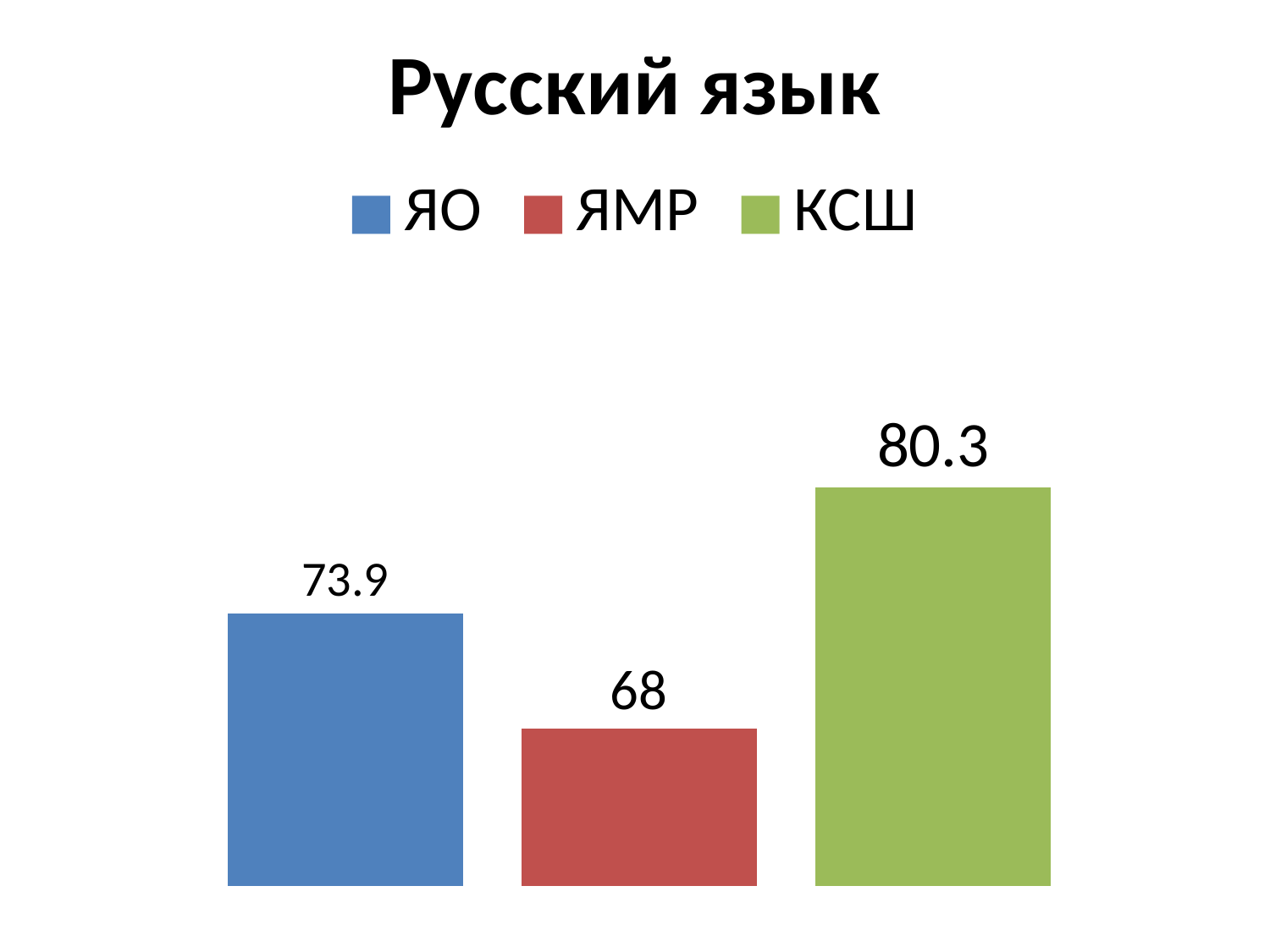
What is the value for КСШ? 80.3 What is the difference between the values for КСШ and ЯО? 6.4 What is the value for ЯМР? 68 What is the difference between the values for ЯО and ЯМР? 5.9 Which series has the highest value? КСШ How many series does the legend list? 3 What is the value for ЯО? 73.9 What is the title of the chart? Русский язык Which is larger, the value for ЯО or the value for ЯМР? ЯО What kind of chart is shown on the slide? bar chart How many bars are shown in the chart? 3 Which series has the lowest value? ЯМР